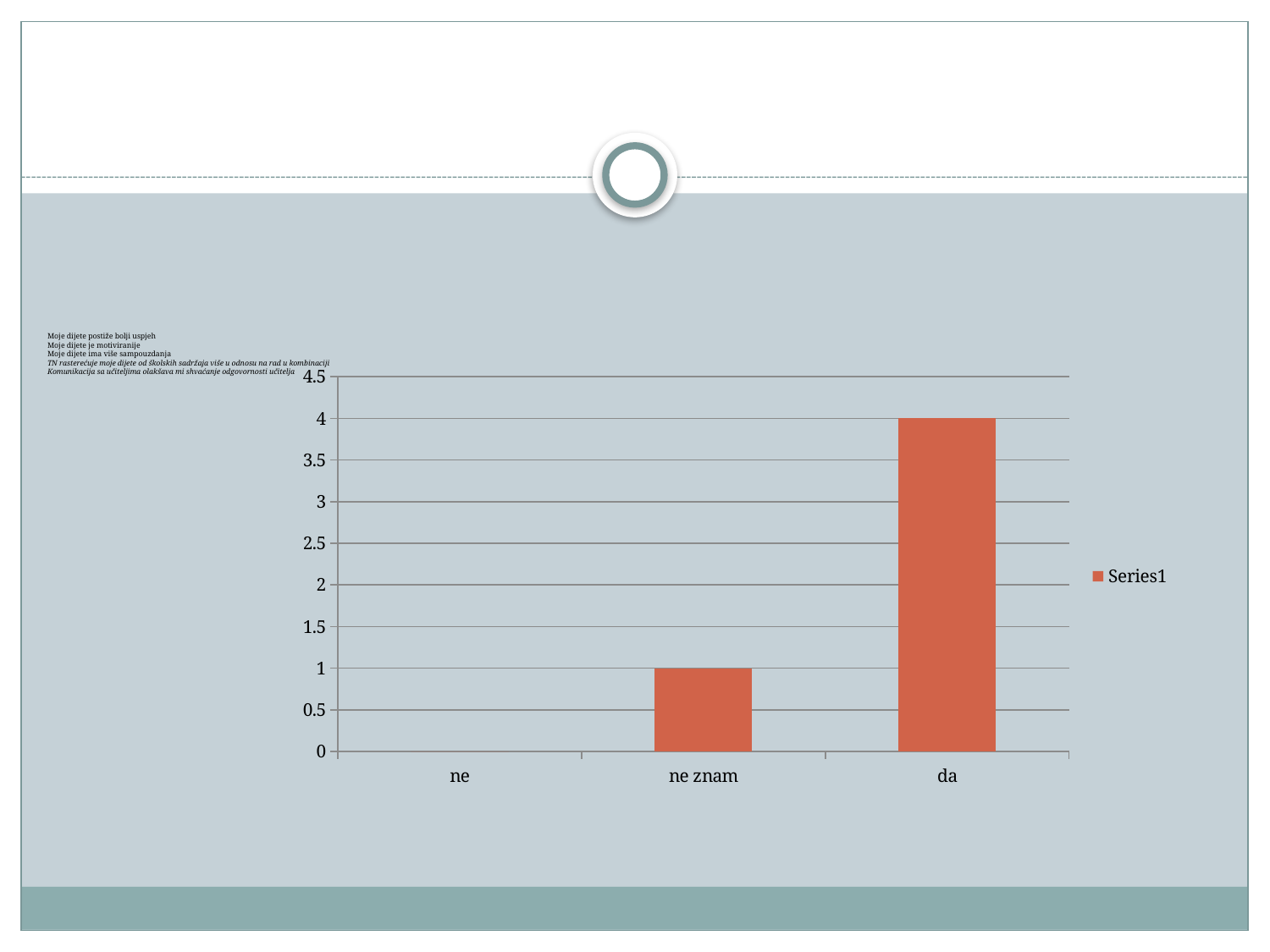
Which category has the lowest value? ne What is the value for 'da'? 4 How many series does the legend list? 1 Do the values rise or fall from left to right along the x axis? rise Which is larger, the value for 'da' or the value for 'ne znam'? da What is the name of the series shown in the legend? Series1 What is the value for 'ne znam'? 1 How many categories are shown on the x axis of the chart? 3 What type of chart is shown on the slide? bar chart Is the value for 'da' greater or less than 3? greater Which category has the highest value? da What is the difference between the values for 'da' and 'ne znam'? 3